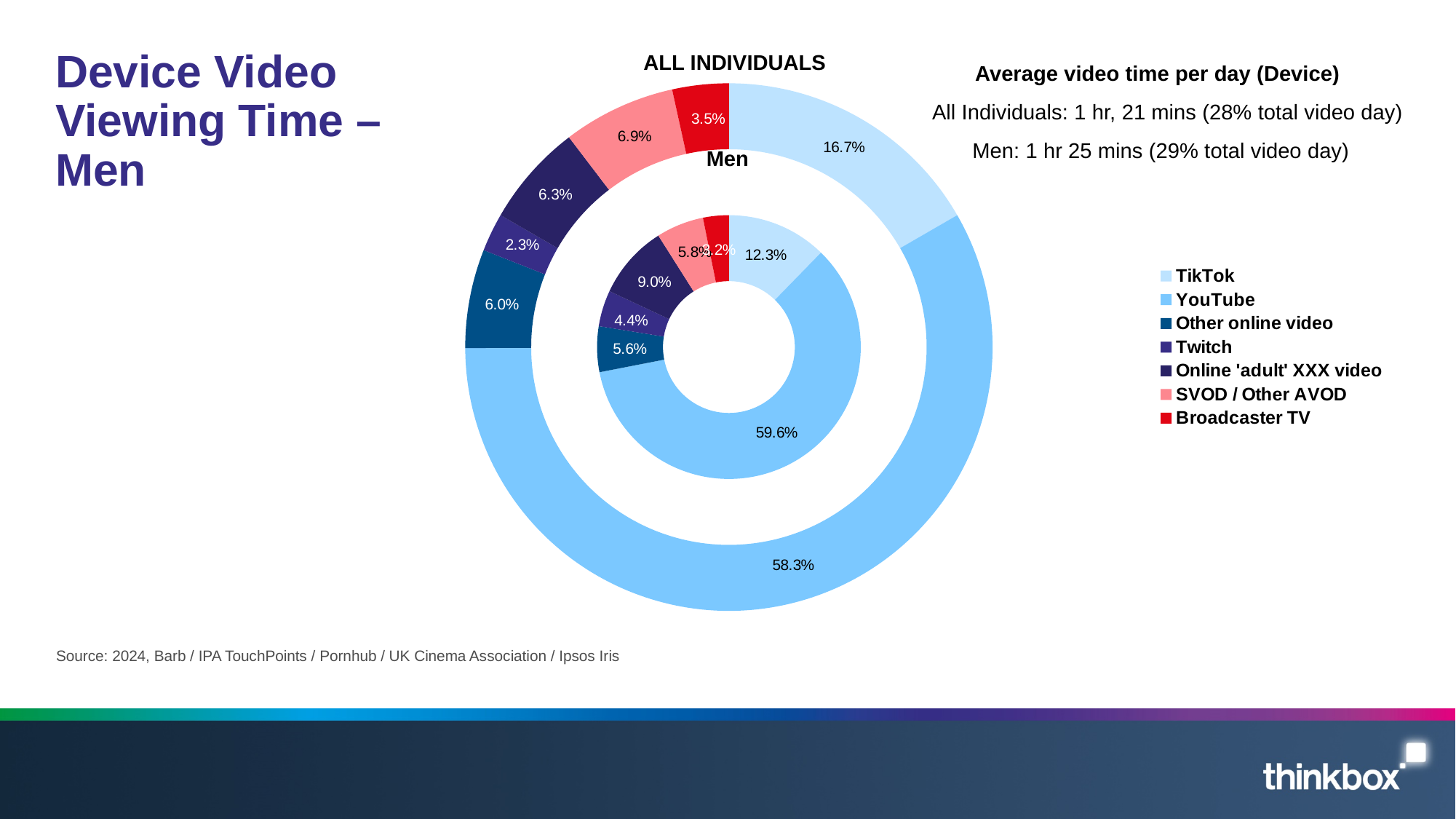
Which ring of the doughnut chart represents Men, the inner or the outer? Inner How many categories does the legend list? 7 What share of the Men ring is TikTok? 12.3% Which is larger in the Men ring: Twitch or Other online video? Other online video What share of the All Individuals ring is YouTube? 58.3% What is the difference between the TikTok share for All Individuals and for Men? 4.4% What kind of chart is shown on the slide? Doughnut chart What is the value for Twitch in the All Individuals ring? 2.3% What is the value for Online 'adult' XXX video in the Men ring? 9.0% Is the YouTube share for Men greater or less than the YouTube share for All Individuals? greater Which category has the largest share in the Men ring? YouTube Which category has the smallest share in the All Individuals ring? Twitch